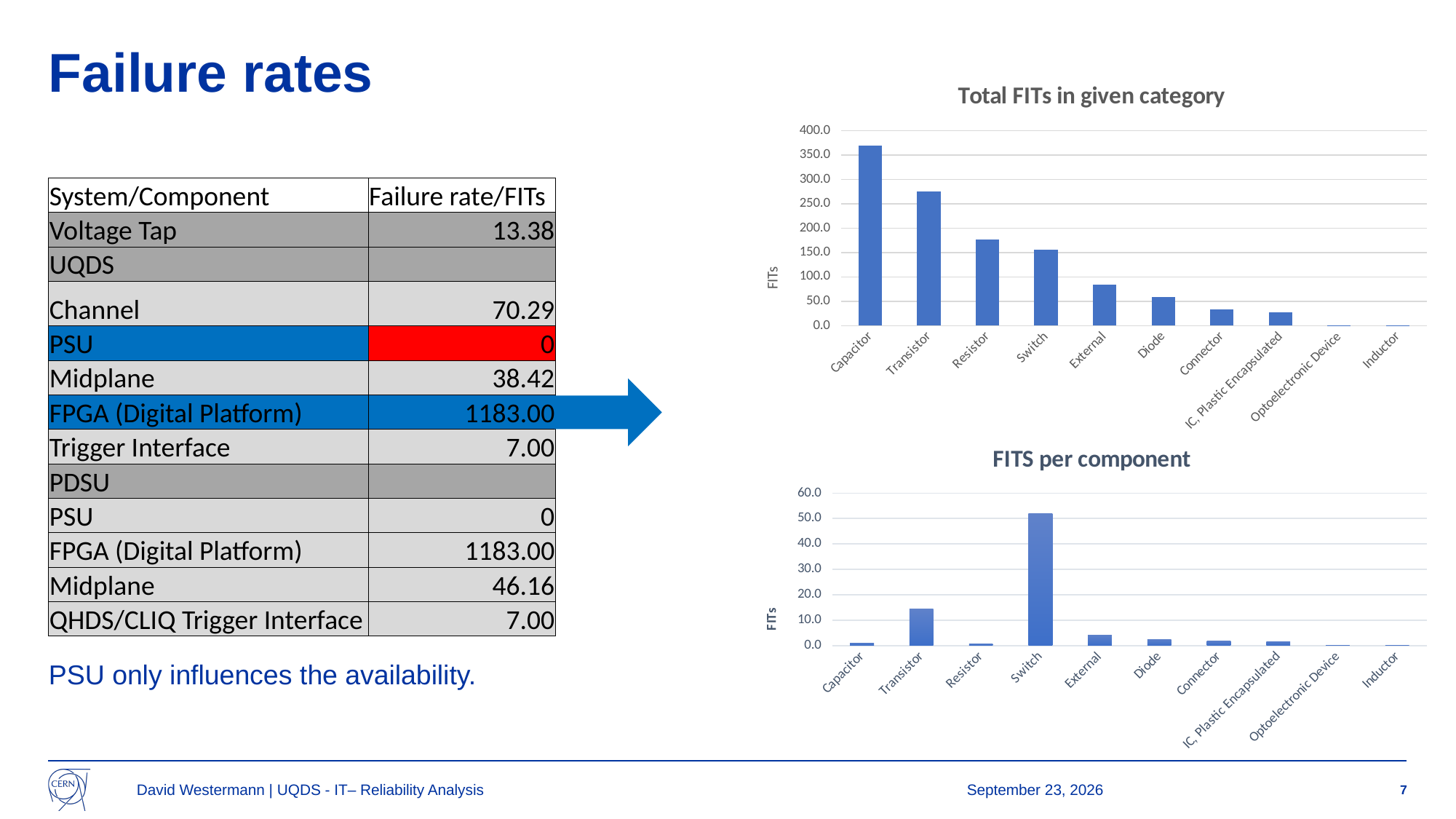
What is the label on the y axis of the "FITS per component" chart? FITs In the "Total FITs in given category" chart, is the value for Capacitor greater or less than 350.0? greater In the "Total FITs in given category" chart, do the values rise or fall from left to right along the x axis? fall In the "FITS per component" chart, which is larger, Transistor or External? Transistor In the "FITS per component" chart, is the value for Switch greater or less than 50.0? greater In the "Total FITs in given category" chart, is the value for External greater or less than 100.0? less In the "FITS per component" chart, which component has the highest value? Switch How many categories are shown on the x axis of the "Total FITs in given category" chart? 10 In the "Total FITs in given category" chart, which is larger, Resistor or Diode? Resistor In the "Total FITs in given category" chart, which category has the highest value? Capacitor What kind of chart is the "Total FITs in given category" chart? bar chart